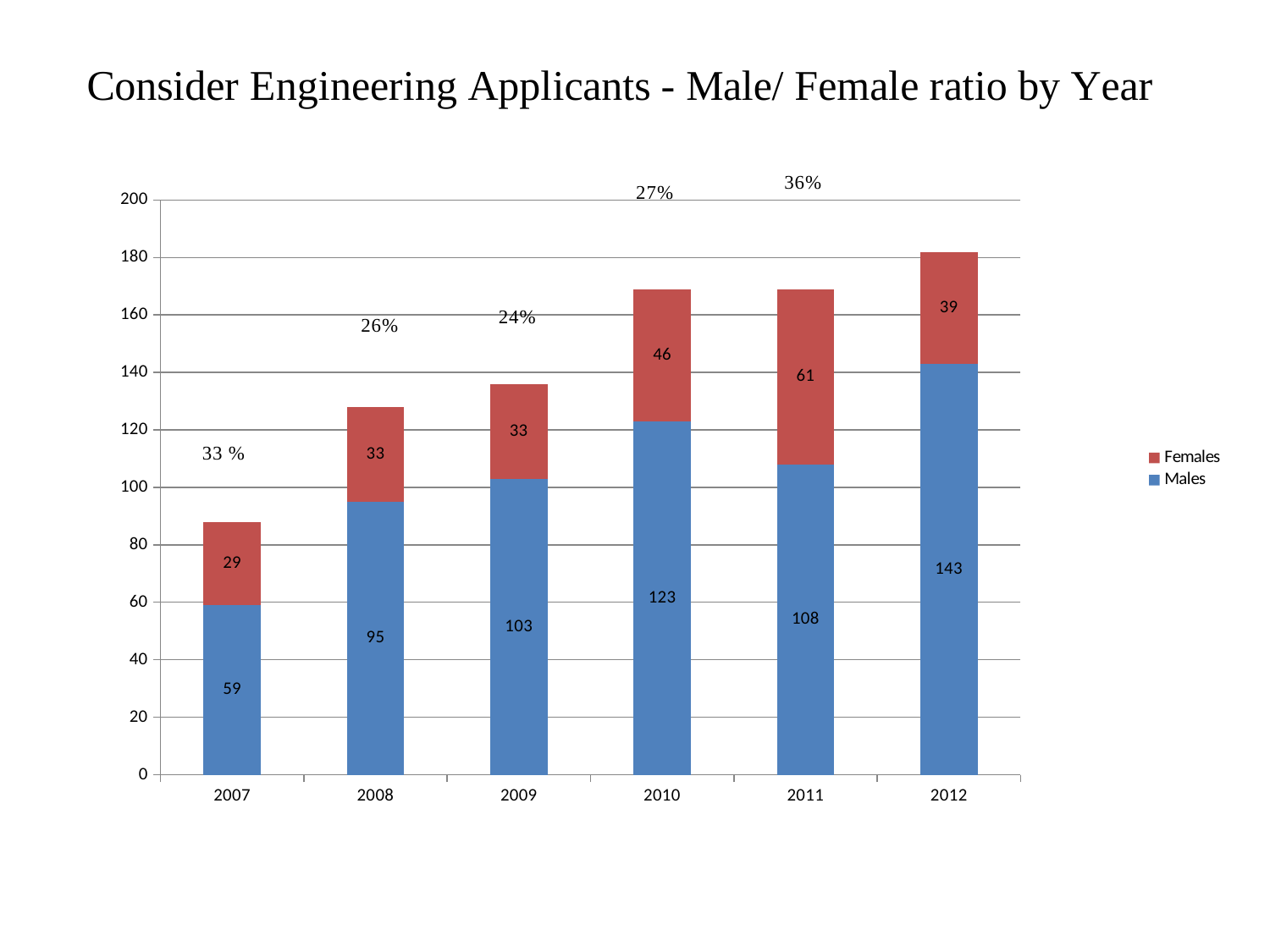
How many series does the legend list? 2 How many males applied in 2010? 123 What is the value for Females in 2011? 61 Which is larger, the number of females in 2010 or the number of females in 2012? 2010 What is the total number of applicants (males plus females) in 2012? 182 What is the difference between the number of males in 2012 and the number of males in 2007? 84 Which colour represents Females in the chart? red How many years are shown on the x axis? 6 Is the total height of the 2009 bar greater or less than 120? greater Which year has the highest number of male applicants? 2012 What kind of chart is shown on the slide? stacked bar chart Which year has the lowest number of female applicants? 2007